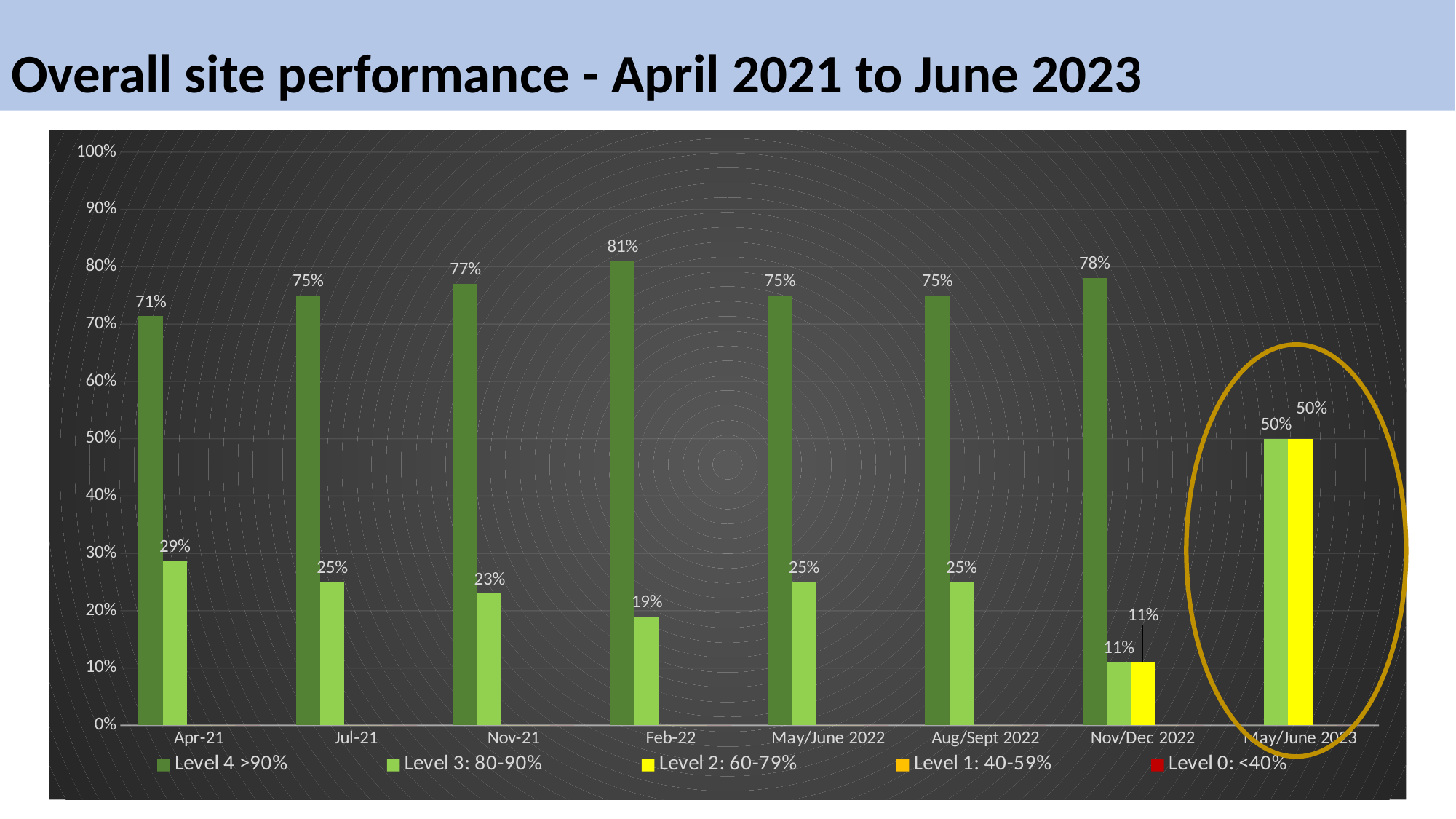
What is the Level 2: 60-79% value for May/June 2023? 50% Which is larger: the Level 3: 80-90% value for Jul-21 or for Feb-22? Jul-21 How many series does the legend list? 5 What is the Level 4 >90% value for Nov/Dec 2022? 78% What is the Level 3: 80-90% value for Apr-21? 29% Which period has the highest Level 4 >90% value? Feb-22 Which period has the lowest Level 3: 80-90% value? Nov/Dec 2022 What is the Level 4 >90% value for Feb-22? 81% How many periods are shown on the x axis? 8 What kind of chart is shown on the slide? Bar chart What is the title of the slide? Overall site performance - April 2021 to June 2023 What is the difference between the Level 4 >90% value for Feb-22 and for Apr-21? 10%